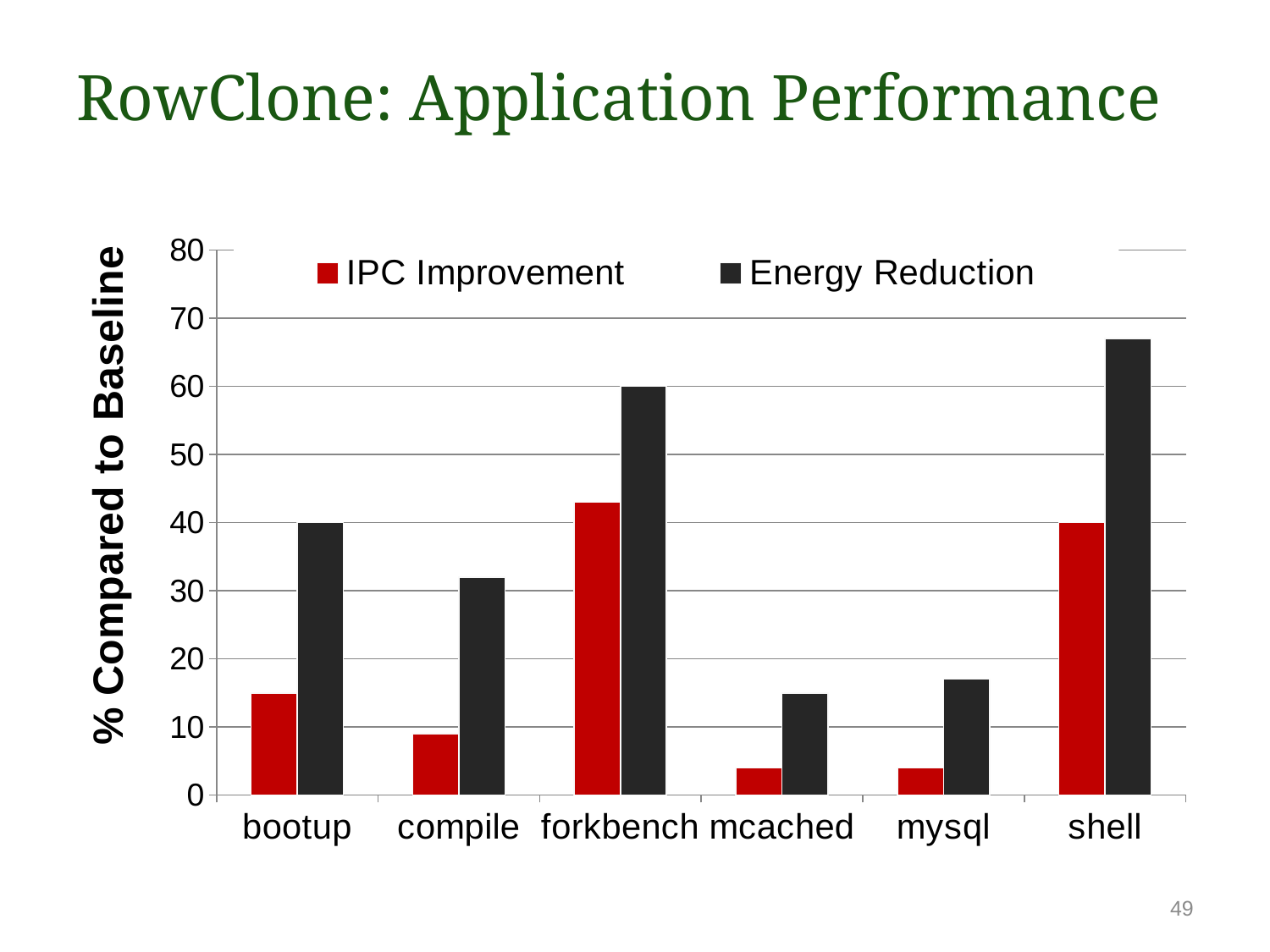
What is the Energy Reduction value for forkbench? 60 What is the Energy Reduction value for bootup? 40 What kind of chart is shown on the slide? bar chart How many series does the legend list? 2 Which application has the highest Energy Reduction? shell Is the Energy Reduction for shell greater or less than 60? greater What is the label of the y axis? % Compared to Baseline Is the IPC Improvement for compile greater or less than 10? less How many application categories are shown on the x axis? 6 Which is larger, the Energy Reduction for bootup or for compile? bootup Is the Energy Reduction for mysql greater or less than 20? less Which application has the highest IPC Improvement? forkbench